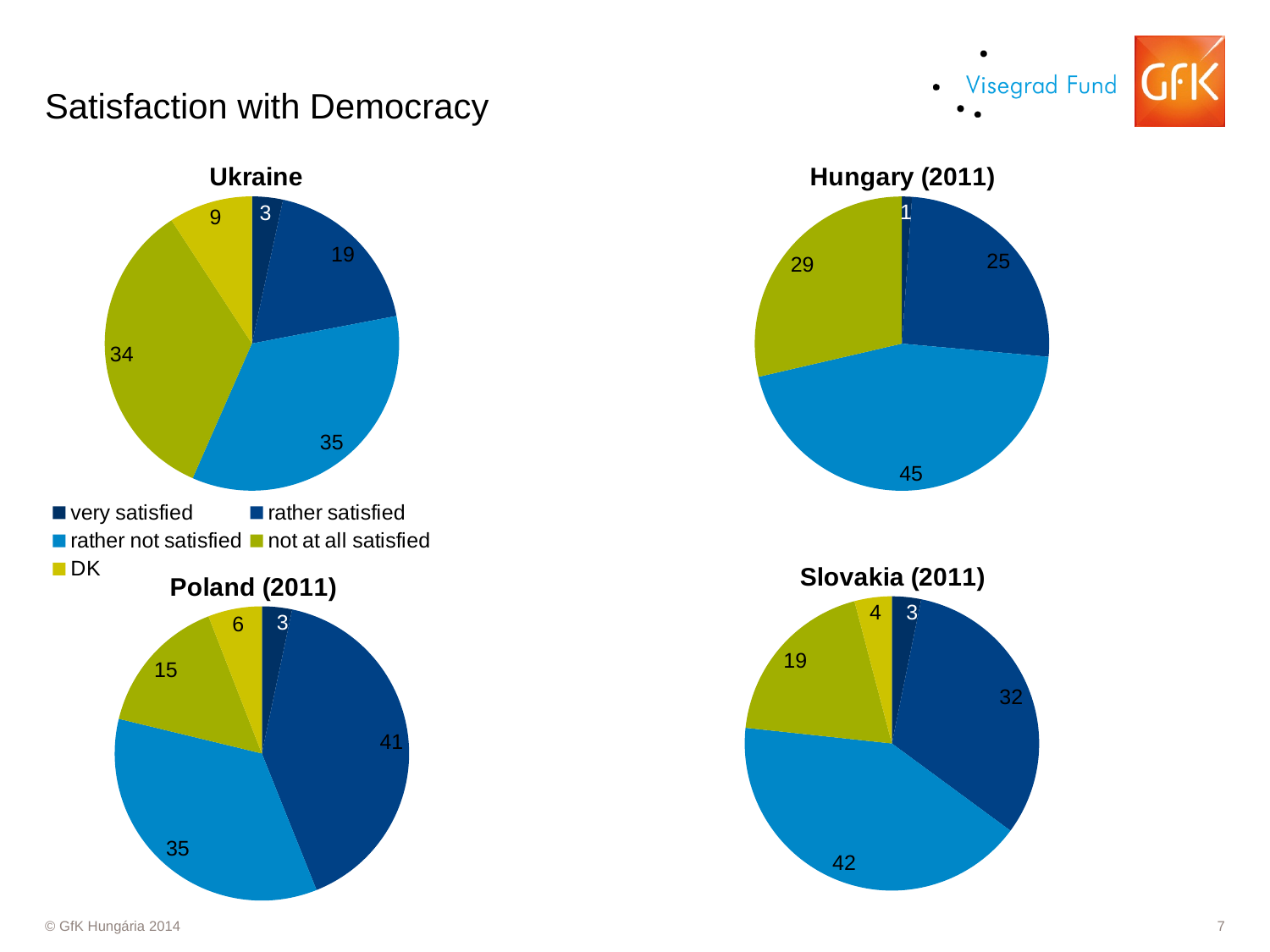
In the Ukraine chart, what is the value for 'rather satisfied'? 19 In the Poland (2011) chart, which category has the largest slice? rather satisfied What is the title of the slide? Satisfaction with Democracy In the Hungary (2011) chart, what is the value for 'not at all satisfied'? 29 In the Poland (2011) chart, which is larger: 'not at all satisfied' or 'DK'? not at all satisfied In the Hungary (2011) chart, which category has the largest slice? rather not satisfied In the Slovakia (2011) chart, which category has the smallest slice? very satisfied How many categories does the legend list? 5 What kind of charts are shown on the slide? pie charts How many pie charts are on the slide? 4 In the Slovakia (2011) chart, what is the difference between 'rather not satisfied' and 'rather satisfied'? 10 In the Ukraine chart, what is the value for 'DK'? 9